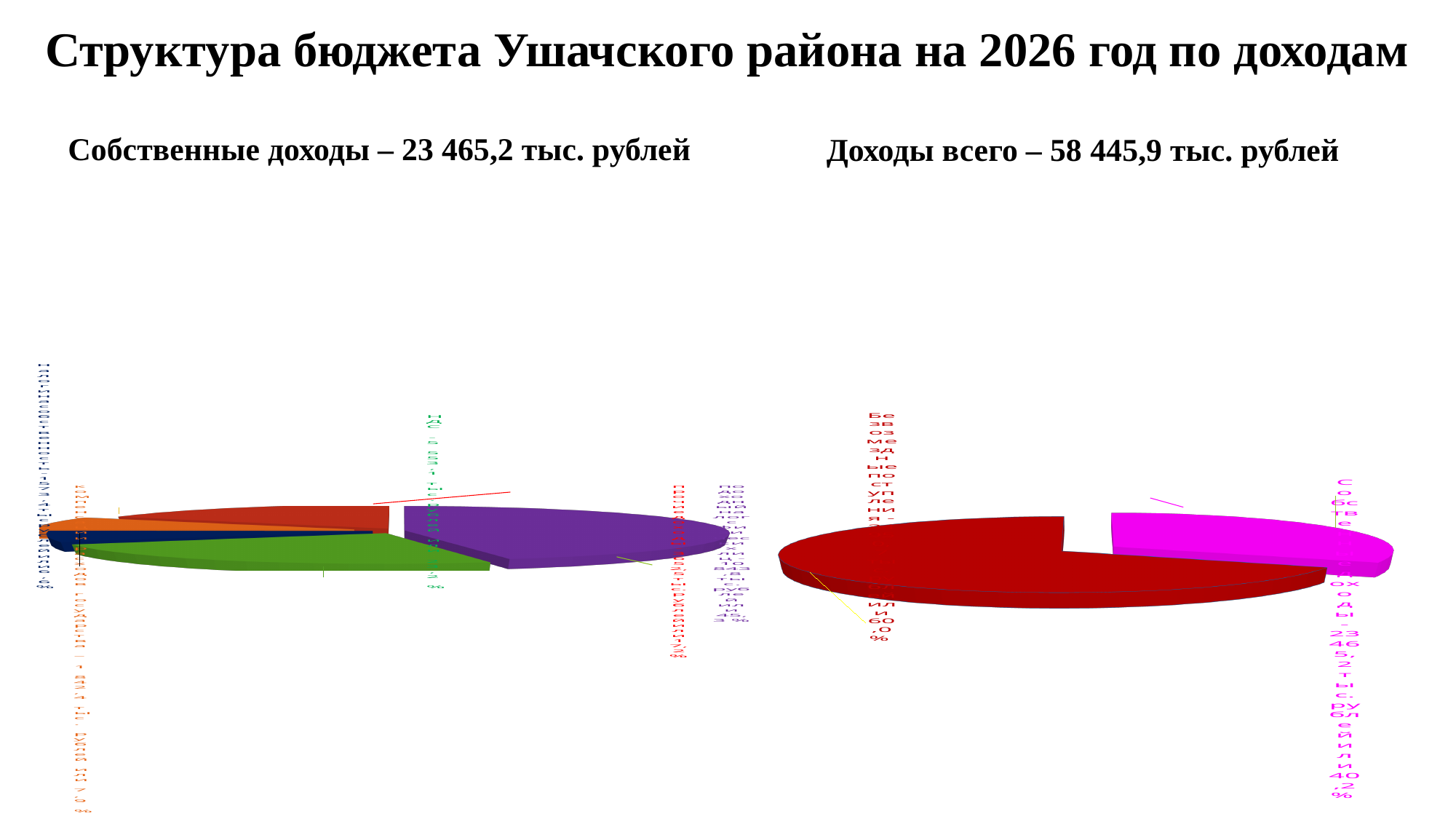
In the right chart (Доходы всего), what value is shown for Собственные доходы? 23 465,2 тыс. рублей What kind of chart is the left chart (Собственные доходы)? pie chart In the right chart (Доходы всего), which slice is the largest? Безвозмездные поступления In the left chart (Собственные доходы), which slice is larger: the green slice or the orange slice? the green slice According to the heading above the right chart, what is the total income (Доходы всего)? 58 445,9 тыс. рублей In the left chart (Собственные доходы), which slice is larger: the purple slice or the red slice? the purple slice In the right chart (Доходы всего), which slice is larger: Безвозмездные поступления or Собственные доходы? Безвозмездные поступления In the right chart (Доходы всего), what colour is the Собственные доходы slice? magenta In the right chart (Доходы всего), how many slices does the pie have? 2 In the right chart (Доходы всего), what share of the pie is Собственные доходы? 40,2% In the left chart (Собственные доходы), how many slices does the pie have? 5 What kind of chart is the right chart (Доходы всего)? pie chart